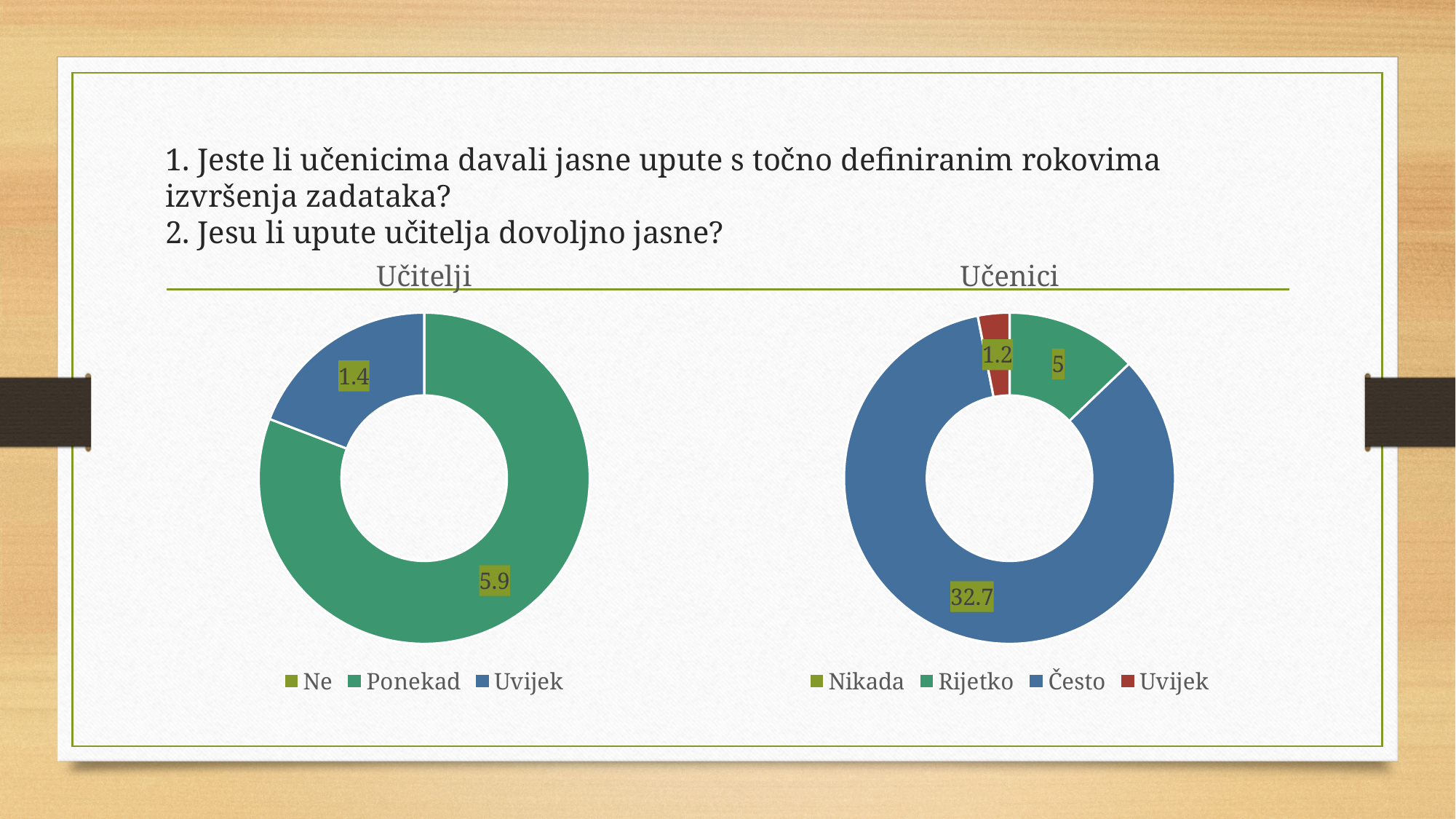
In the Učenici chart, what is the value for Uvijek? 1.2 In the Učitelji chart, what is the value for Uvijek? 1.4 In the Učitelji chart, what is the value for Ponekad? 5.9 How many categories does the legend of the Učenici chart list? 4 In the Učenici chart, which category has the largest slice? Često In the Učenici chart, what is the value for Rijetko? 5 What kind of chart is the Učitelji chart? Doughnut (pie) chart In the Učenici chart, what is the value for Često? 32.7 In the Učenici chart, what is the difference between the values for Često and Rijetko? 27.7 How many categories does the legend of the Učitelji chart list? 3 In the Učitelji chart, what is the difference between the values for Ponekad and Uvijek? 4.5 In the Učitelji chart, which category has the larger slice, Ponekad or Uvijek? Ponekad